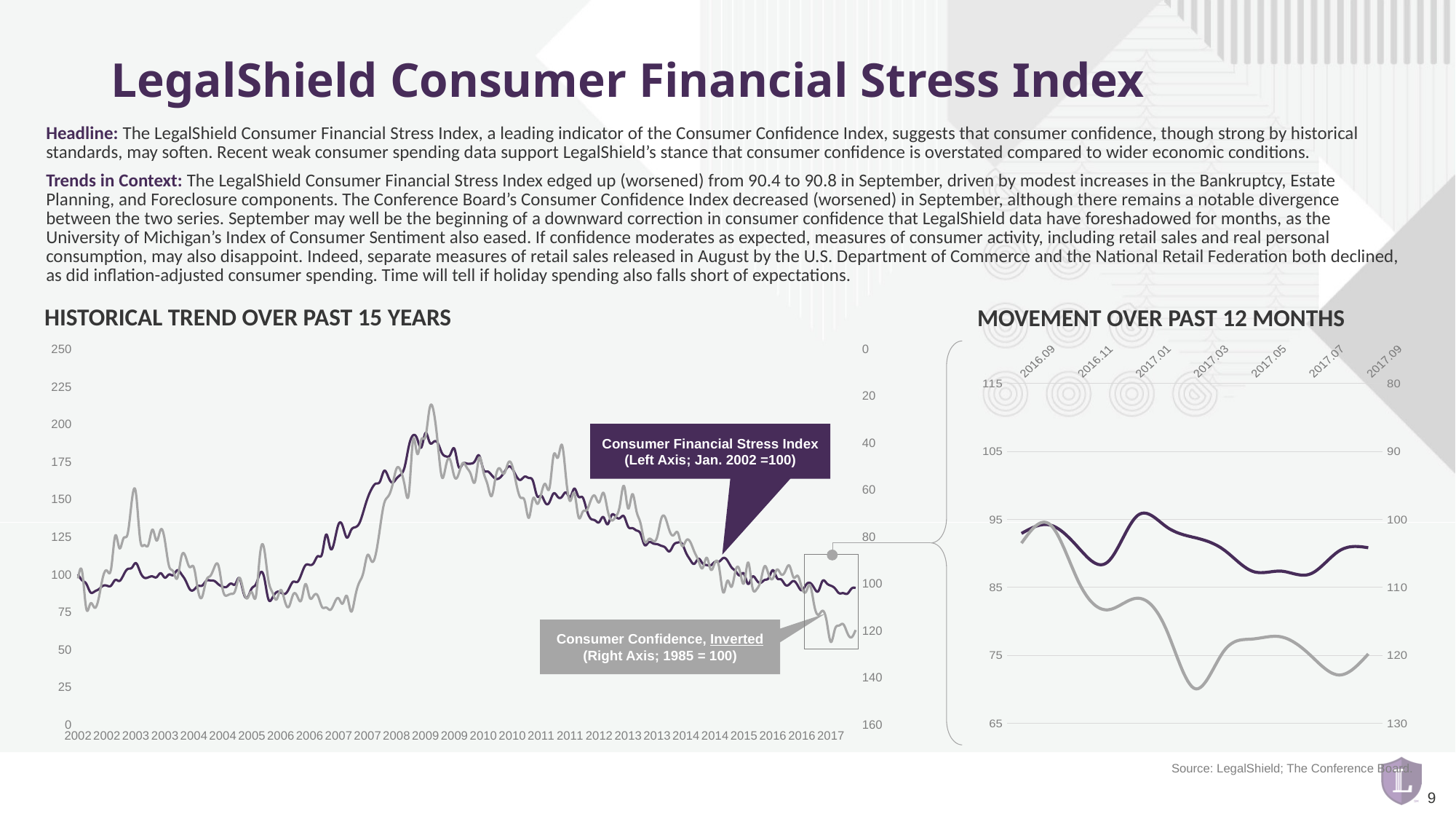
In the 'MOVEMENT OVER PAST 12 MONTHS' chart, does the Consumer Financial Stress Index rise or fall from 2016.09 to 2016.11? Fall In the 'HISTORICAL TREND OVER PAST 15 YEARS' chart, is the Consumer Financial Stress Index higher in 2009 or in 2017? 2009 How many series are plotted in the 'HISTORICAL TREND OVER PAST 15 YEARS' chart? 2 In the 'HISTORICAL TREND OVER PAST 15 YEARS' chart, does the Consumer Financial Stress Index rise or fall from 2009 to 2017? Fall In the 'MOVEMENT OVER PAST 12 MONTHS' chart, is the Consumer Financial Stress Index higher at 2017.01 or at 2017.05? 2017.01 How many labelled months are shown on the x axis of the 'MOVEMENT OVER PAST 12 MONTHS' chart? 7 In the 'HISTORICAL TREND OVER PAST 15 YEARS' chart, is the Consumer Financial Stress Index in 2017 greater or less than 100 on the left axis? less In the 'HISTORICAL TREND OVER PAST 15 YEARS' chart, what base period is used for the Consumer Financial Stress Index? Jan. 2002 = 100 In the 'MOVEMENT OVER PAST 12 MONTHS' chart, is the Consumer Financial Stress Index at 2017.05 greater or less than 95 on the left axis? less In the 'HISTORICAL TREND OVER PAST 15 YEARS' chart, which series is plotted on the right axis? Consumer Confidence, Inverted In the 'HISTORICAL TREND OVER PAST 15 YEARS' chart, is the Consumer Financial Stress Index peak around 2009 greater or less than 150 on the left axis? greater What kind of chart is the 'HISTORICAL TREND OVER PAST 15 YEARS' chart? Line chart